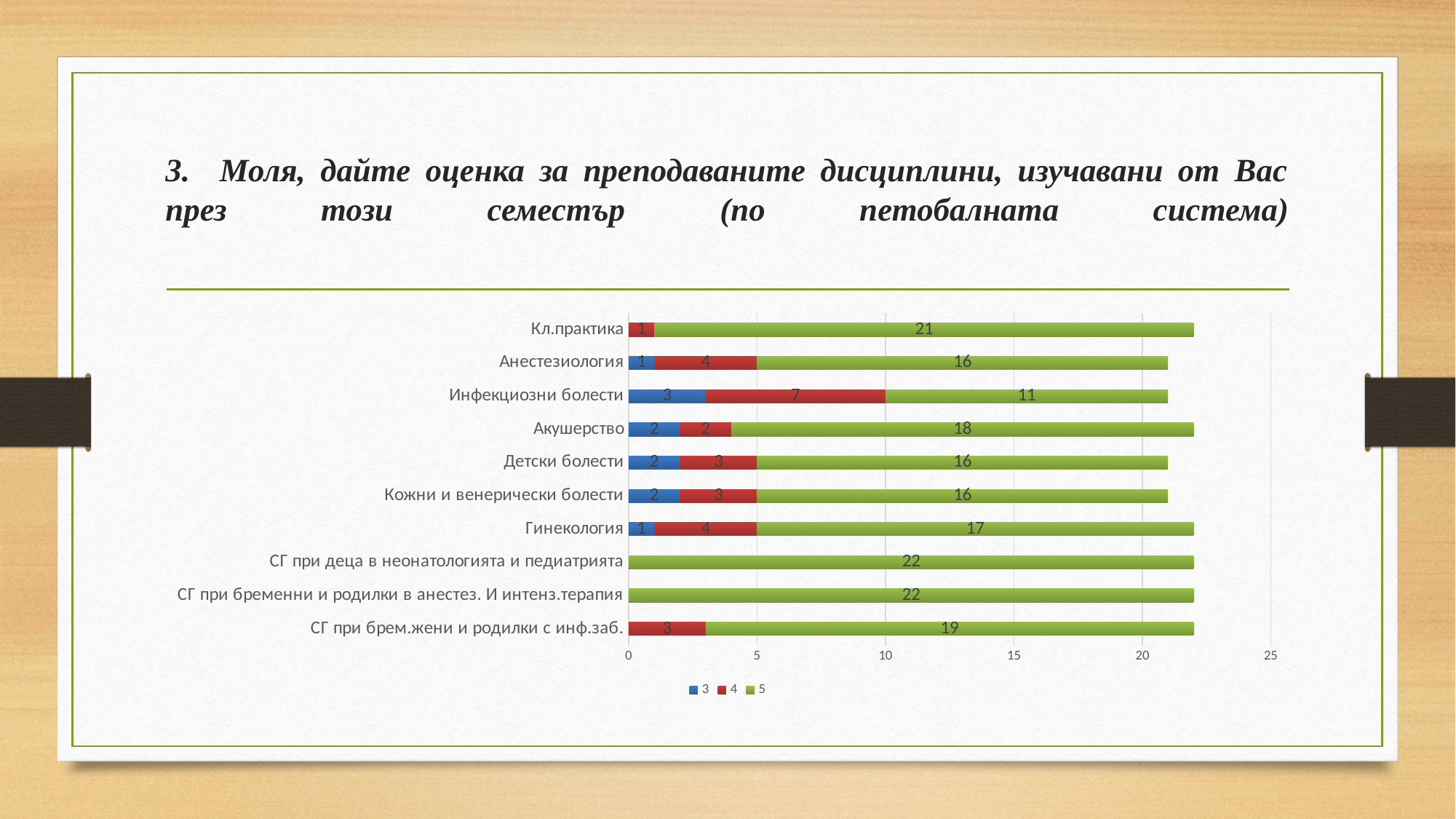
What is the value of series "4" for Инфекциозни болести? 7 What is the difference between the series "5" values for Акушерство and Гинекология? 1 Which category has the highest value for series "4"? Инфекциозни болести How many categories are shown on the chart? 10 What is the total of the stacked bar for Инфекциозни болести? 21 Which category has the lowest value for series "5"? Инфекциозни болести What is the value of series "5" for Кл.практика? 21 What are the legend entries of the chart? 3, 4, 5 What is the value of series "3" for Акушерство? 2 What kind of chart is shown on the slide? Stacked bar chart How many series does the legend list? 3 Which is larger: the series "5" value for Анестезиология or for СГ при брем.жени и родилки с инф.заб.? СГ при брем.жени и родилки с инф.заб.